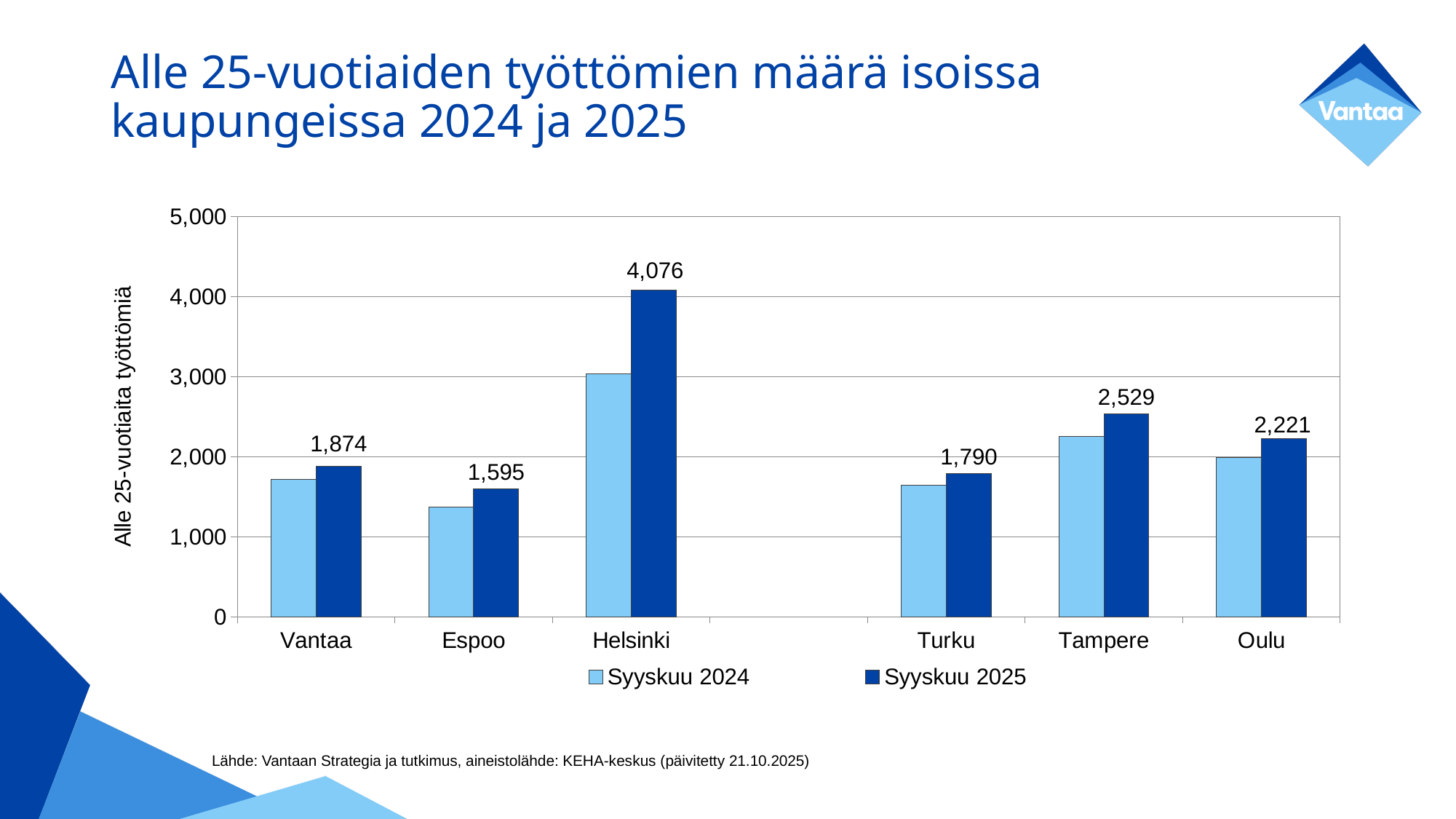
Is the Syyskuu 2024 value for Tampere greater or less than 2,000? greater Which city has the highest value in the Syyskuu 2025 series? Helsinki What kind of chart is shown on the slide? bar chart What are the two series named in the legend? Syyskuu 2024 and Syyskuu 2025 How many series does the legend list? 2 What is the difference between the Syyskuu 2025 values for Vantaa and Espoo? 279 What is the difference between the Syyskuu 2025 values for Tampere and Oulu? 308 How many cities are shown on the x axis? 6 Which city has the lowest value in the Syyskuu 2025 series? Espoo In the Syyskuu 2025 series, which is larger: Turku or Vantaa? Vantaa What is the value for Helsinki in the Syyskuu 2025 series? 4,076 What is the value for Vantaa in the Syyskuu 2025 series? 1,874